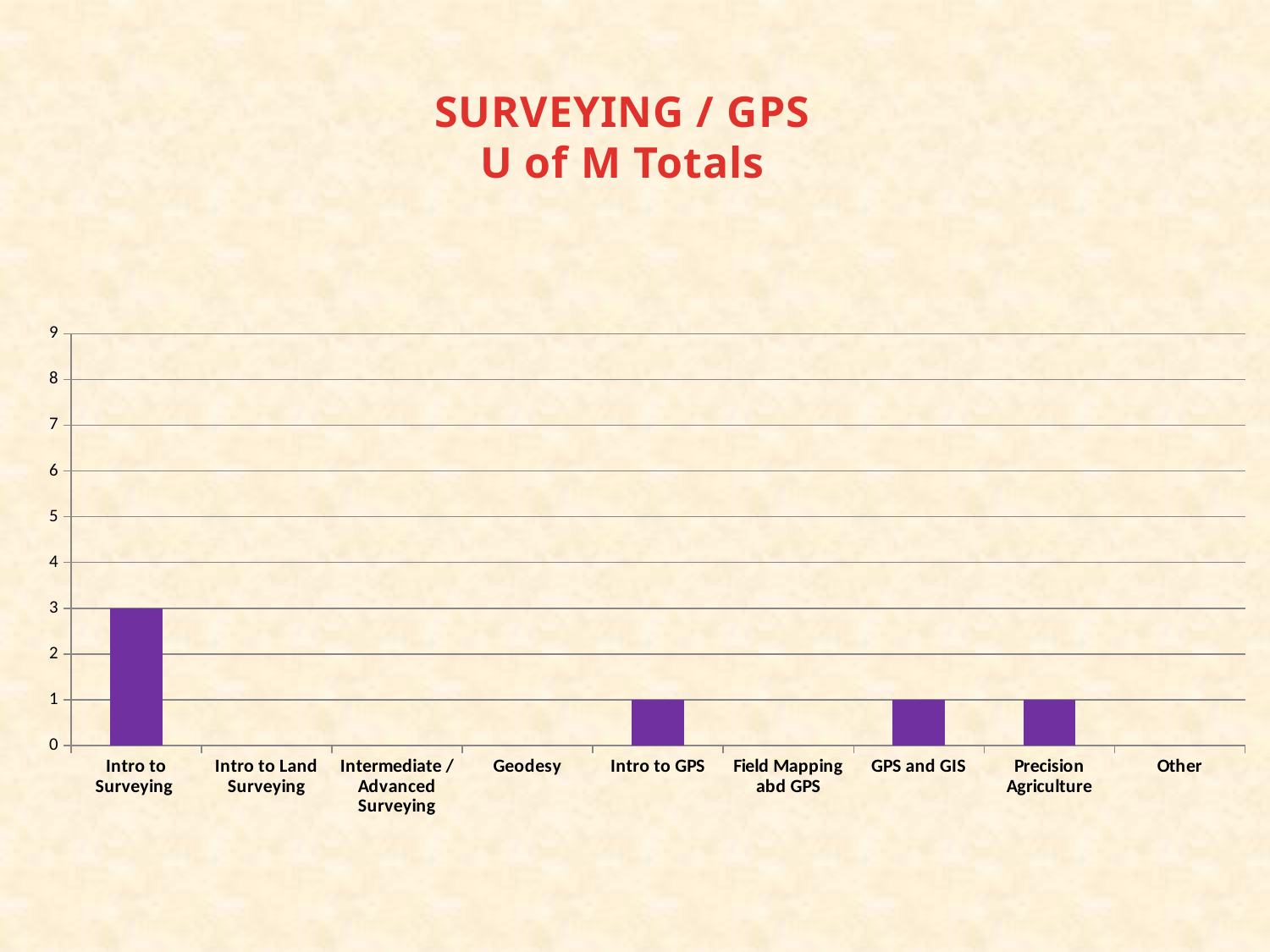
Which is larger, the value for Intro to Surveying or the value for Precision Agriculture? Intro to Surveying What is the value for Intro to Surveying? 3 Which category has the highest value? Intro to Surveying What is the title of the chart? SURVEYING / GPS U of M Totals How many categories are shown on the x axis? 9 What is the value for GPS and GIS? 1 What is the highest value shown on the vertical axis? 9 What is the value for Intro to GPS? 1 What is the value for Precision Agriculture? 1 Is the value for Intro to Surveying greater or less than 5? less What is the difference between the values for Intro to Surveying and Intro to GPS? 2 What type of chart is shown on the slide? Bar chart